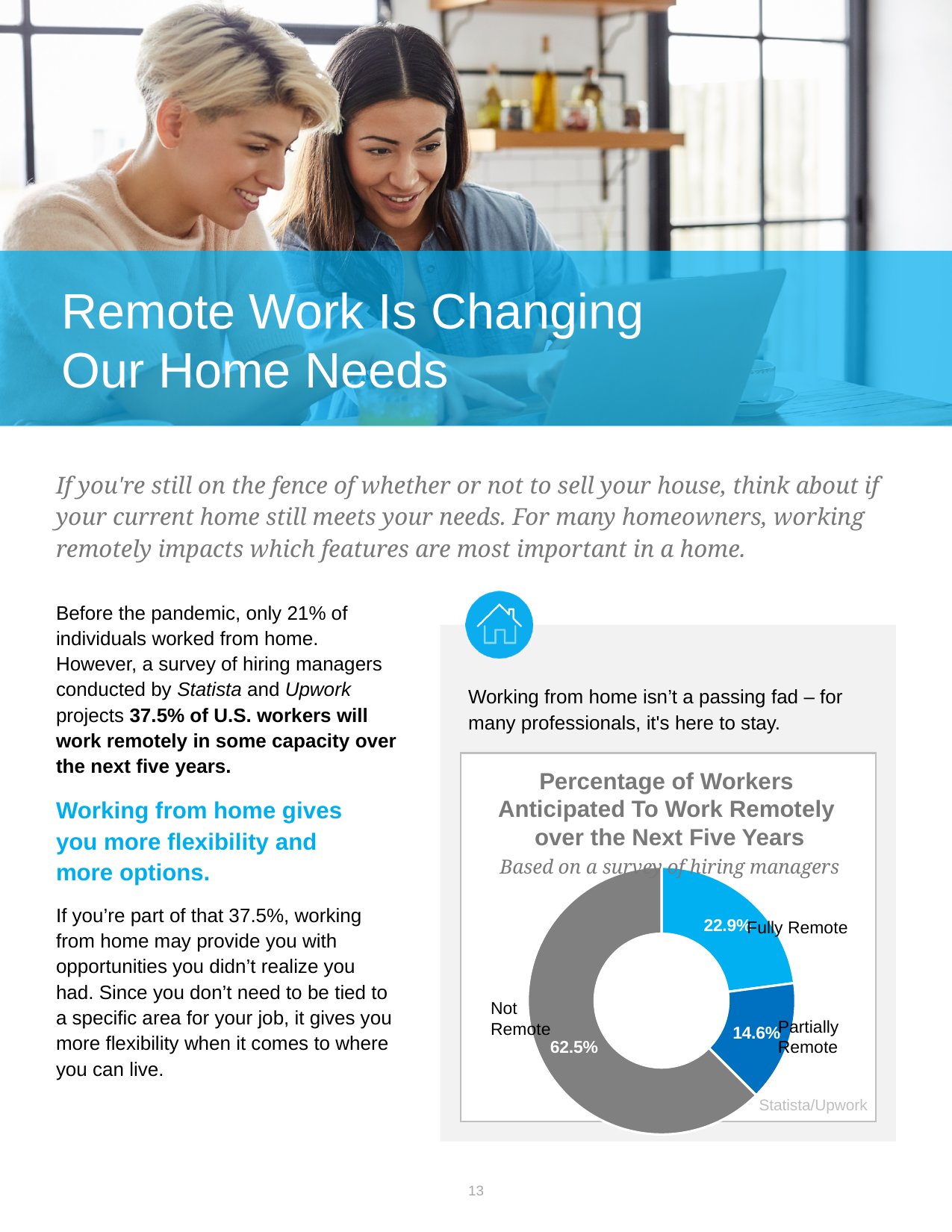
What percentage of workers are anticipated to be Fully Remote? 22.9% What is the title of the chart? Percentage of Workers Anticipated To Work Remotely over the Next Five Years What is the difference between the Fully Remote and Partially Remote percentages? 8.3% What kind of chart is shown on the slide? Pie chart (doughnut) What source is cited for the chart? Statista/Upwork Which category has the smallest share of the chart? Partially Remote What percentage of workers are anticipated to be Partially Remote? 14.6% What is the combined percentage of Fully Remote and Partially Remote workers? 37.5% What percentage of workers are anticipated to be Not Remote? 62.5% How many categories are shown in the chart? 3 Which is larger, the Fully Remote share or the Partially Remote share? Fully Remote Which category has the largest share of the chart? Not Remote